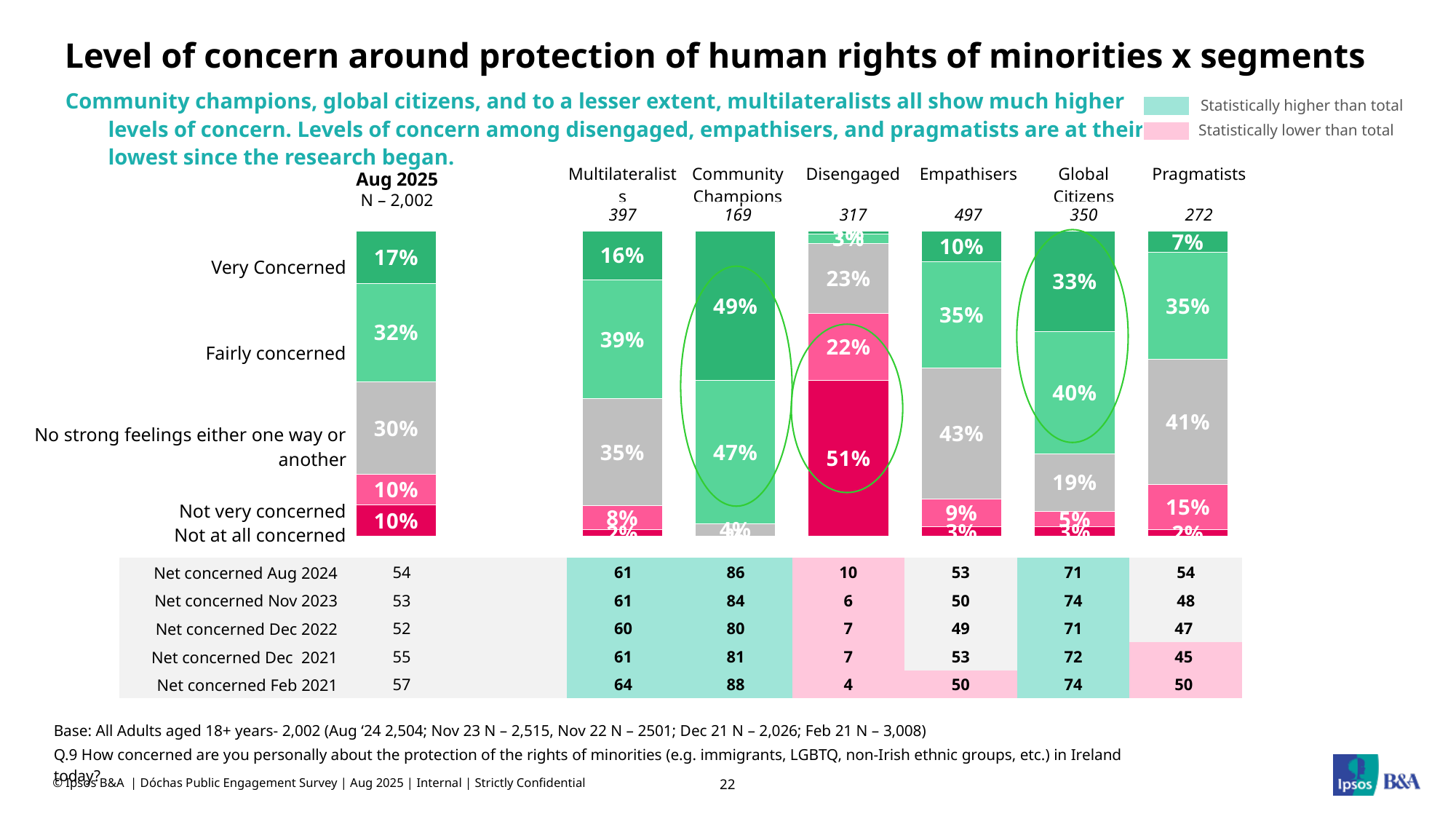
What percentage of the Disengaged segment is Not at all concerned? 51% What percentage of Global Citizens are Fairly concerned? 40% What type of chart is used to show the levels of concern? Stacked bar chart What is the difference between the Very Concerned share for Global Citizens and for Multilateralists? 17 percentage points Which is larger: the Fairly concerned share for Multilateralists or for Empathisers? Multilateralists What is the sample size shown for the Empathisers segment? 497 What percentage of Community Champions are Very Concerned? 49% What percentage of Pragmatists have no strong feelings either one way or another? 41% Which segment has the lowest share of Fairly concerned respondents? Disengaged Which segment has the highest share of Very Concerned respondents? Community Champions What percentage of the total Aug 2025 sample is Very Concerned? 17% How many segment bars are shown alongside the total Aug 2025 bar? 6